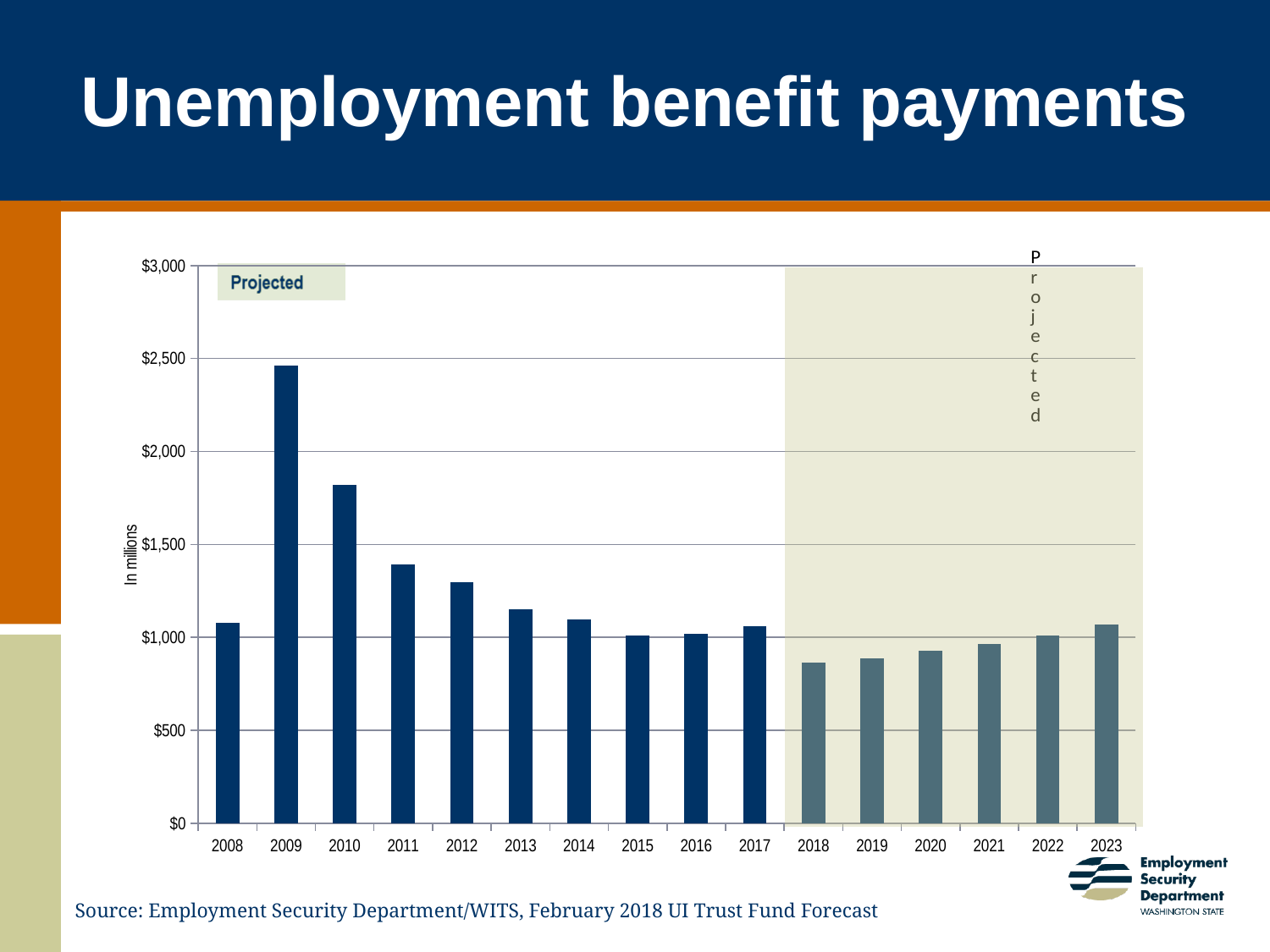
What label is given to the shaded region covering 2018 to 2023? Projected Is the value for 2010 greater or less than $1,500? greater Which year has the highest unemployment benefit payments? 2009 Is the value for 2012 greater or less than $1,500? less What is the label on the y axis of the chart? In millions Is the value for 2009 greater or less than $2,000? greater How many years are plotted on the x axis of the chart? 16 Which year has the lowest unemployment benefit payments? 2018 What kind of chart is shown on the slide? bar chart Do the values rise or fall from 2018 to 2023? rise Which year has the larger value, 2010 or 2011? 2010